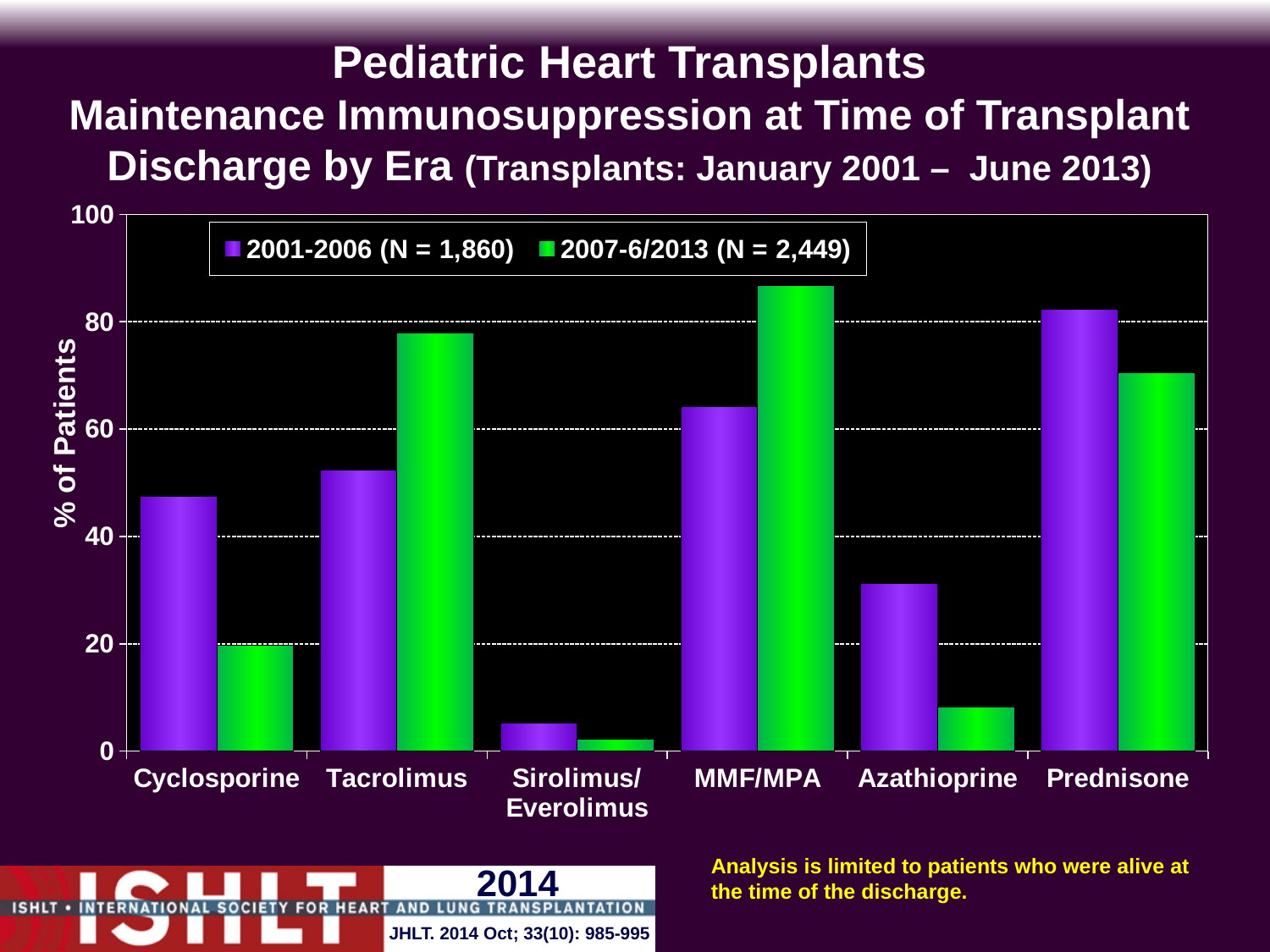
How many drug categories are shown on the x axis? 6 For Prednisone, which era has the larger value, 2001-2006 or 2007-6/2013? 2001-2006 What kind of chart is shown on the slide? bar chart Which drug has the highest value for the 2001-2006 era? Prednisone How many series does the legend list? 2 Is the value for Cyclosporine in 2001-2006 greater or less than 40? greater What is the label on the y axis? % of Patients Which drug has the highest value for the 2007-6/2013 era? MMF/MPA Is the value for Azathioprine in 2007-6/2013 greater or less than 20? less Which drug has the lowest value for the 2001-2006 era? Sirolimus/Everolimus Is the value for Tacrolimus in 2007-6/2013 greater or less than 60? greater For Tacrolimus, which era has the larger value, 2001-2006 or 2007-6/2013? 2007-6/2013